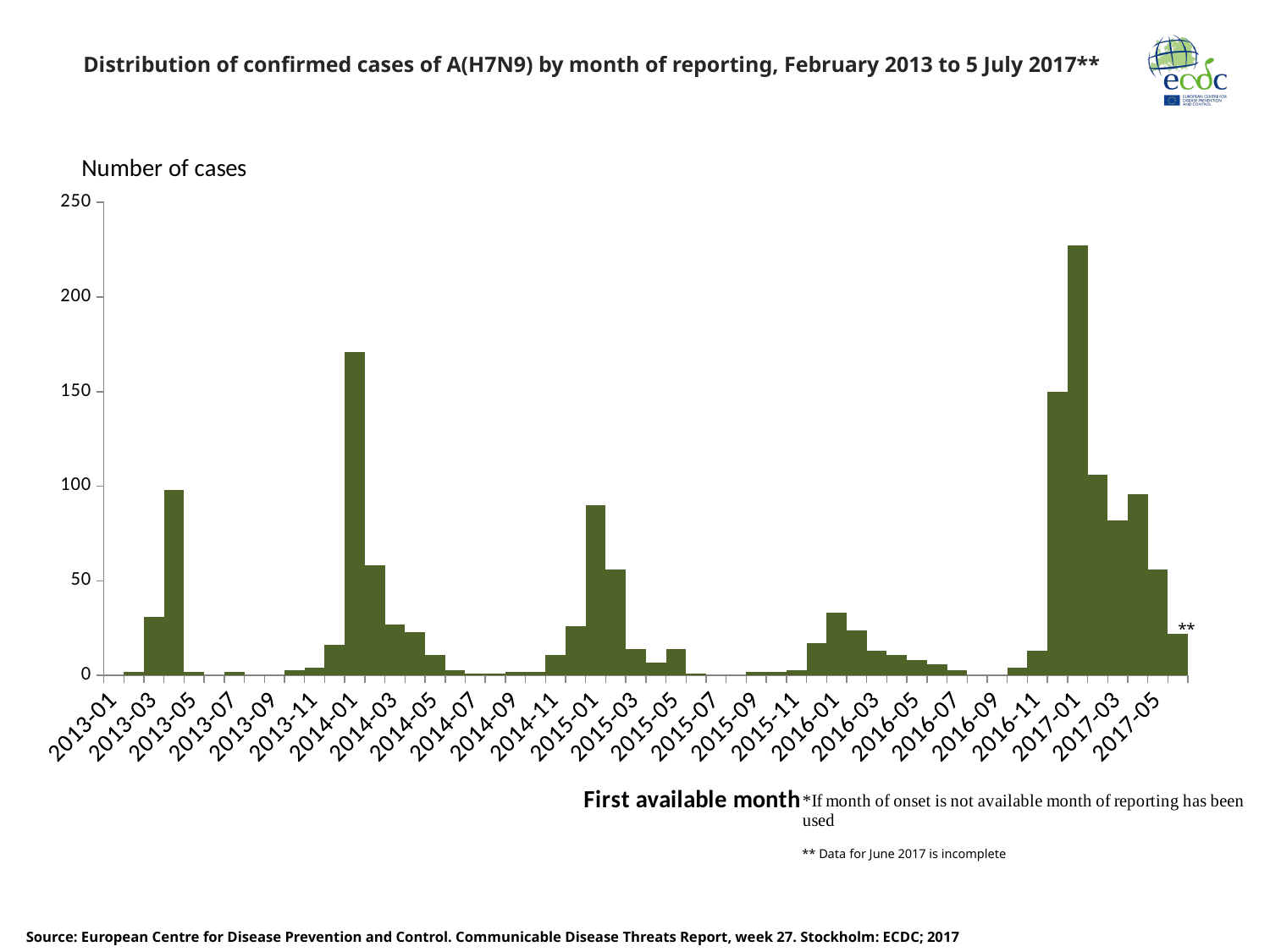
Do the values rise or fall from 2014-01 to 2014-07? fall What is the title of the vertical axis? Number of cases Is the value for 2014-01 greater or less than 150? greater Which month has more cases, 2014-01 or 2015-01? 2014-01 Which month has the highest number of cases? 2017-01 Is the value for 2013-03 greater or less than 50? less What kind of chart is shown on the slide? bar chart Is the value for 2017-01 greater or less than 200? greater What is the title of the horizontal axis? First available month